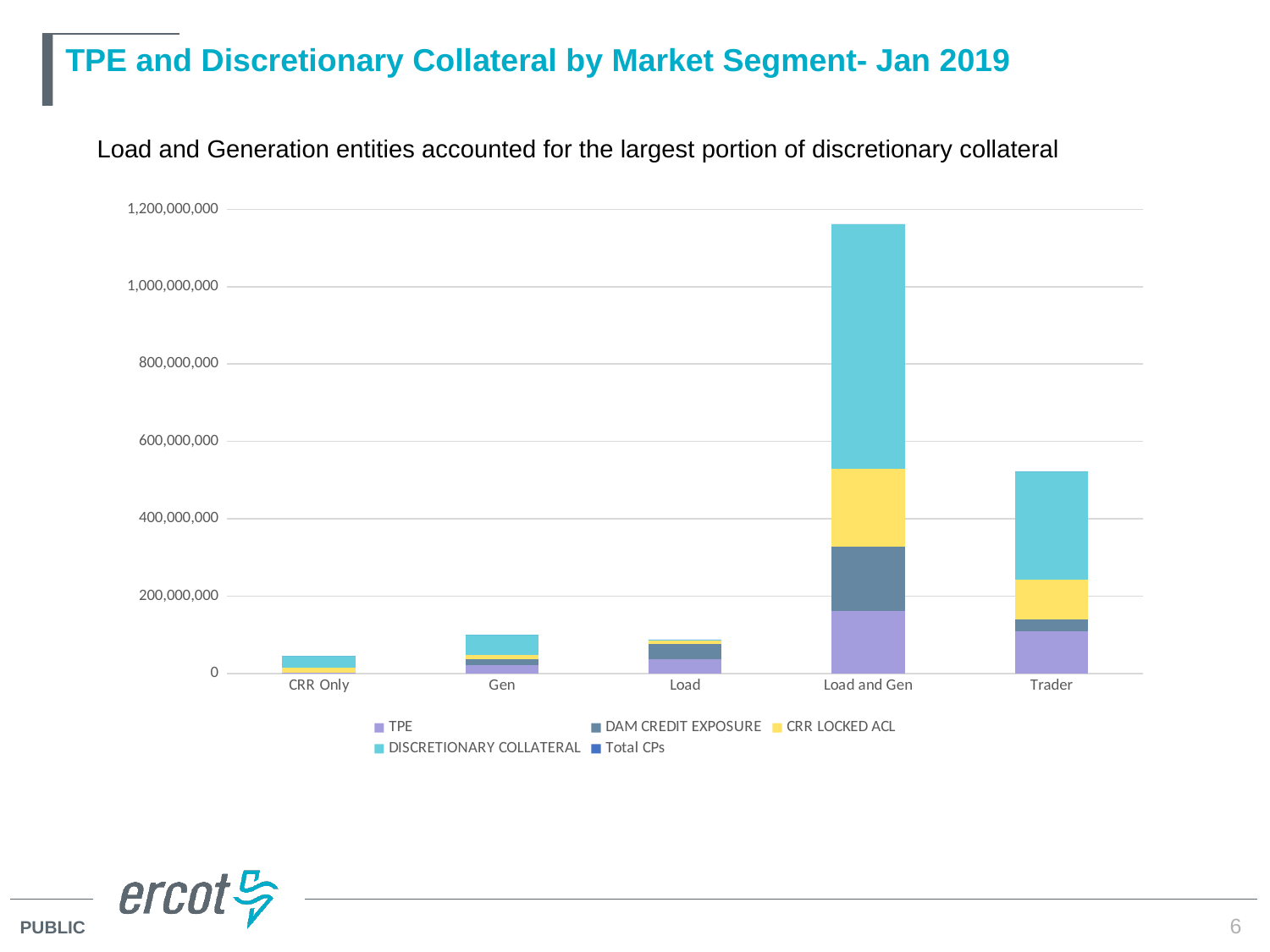
How many market segment categories are shown on the x axis? 5 Is the total stacked value for Gen greater or less than 200,000,000? less Is the total stacked value for Load and Gen greater or less than 1,000,000,000? greater What is the title of the slide containing the chart? TPE and Discretionary Collateral by Market Segment- Jan 2019 Which has a taller stacked bar, Load and Gen or Trader? Load and Gen Which series is shown in yellow in the legend? CRR LOCKED ACL Which market segment has the shortest stacked bar? CRR Only Is the total stacked value for Trader greater or less than 400,000,000? greater What kind of chart is shown on the slide? Stacked bar chart Which has a taller stacked bar, CRR Only or Trader? Trader How many series does the legend list? 5 Which market segment has the tallest stacked bar? Load and Gen